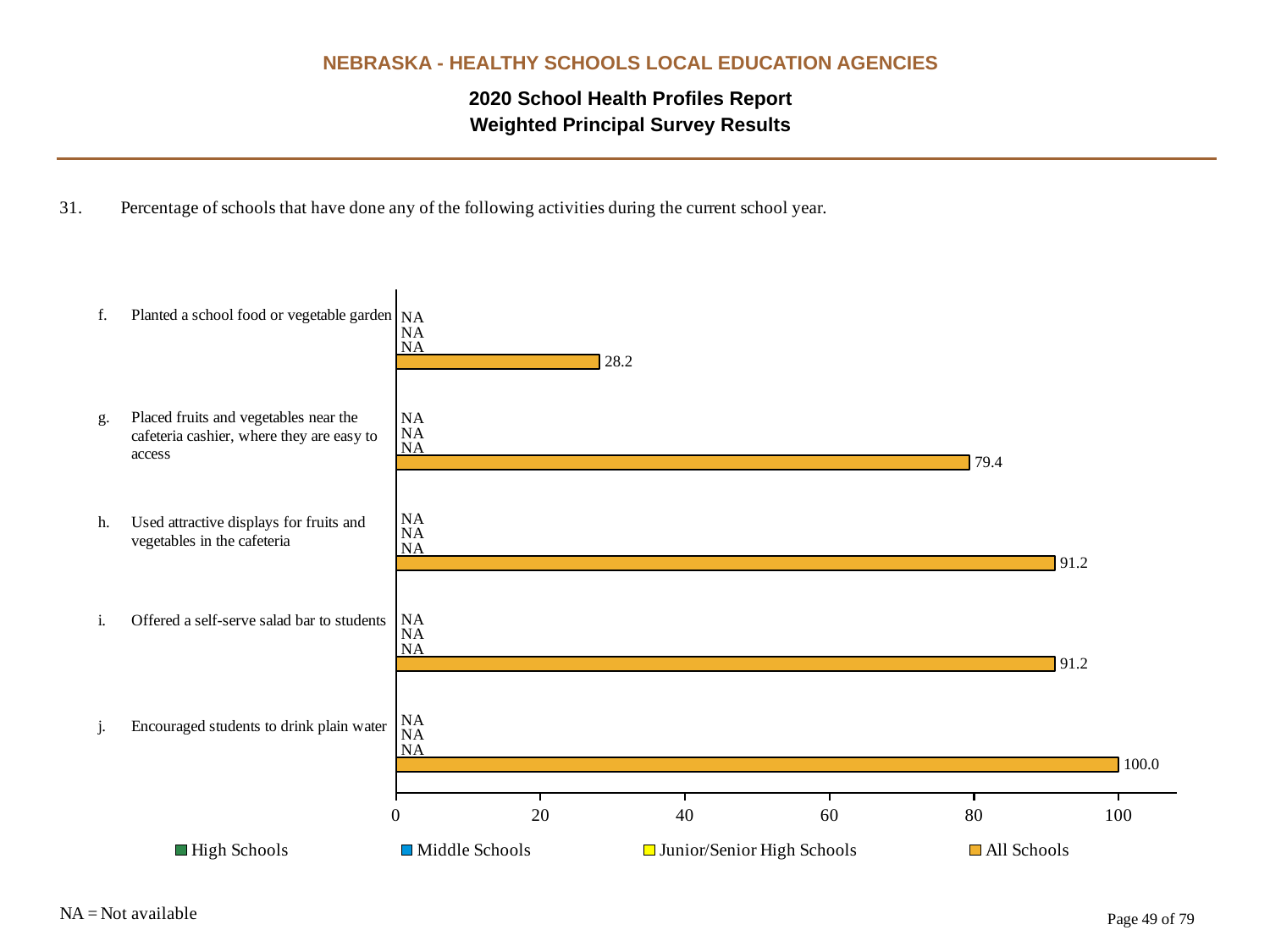
What is the difference between the All Schools values for 'Encouraged students to drink plain water' and 'Planted a school food or vegetable garden'? 71.8 What value is shown for High Schools for 'Offered a self-serve salad bar to students'? NA How many activities (categories) are shown in the chart? 5 Which has a larger All Schools value: 'Placed fruits and vegetables near the cafeteria cashier' or 'Used attractive displays for fruits and vegetables in the cafeteria'? Used attractive displays for fruits and vegetables in the cafeteria How many series does the legend list? 4 What is the All Schools value for 'Placed fruits and vegetables near the cafeteria cashier, where they are easy to access'? 79.4 What is the All Schools value for 'Encouraged students to drink plain water'? 100.0 What is the All Schools value for 'Planted a school food or vegetable garden'? 28.2 What kind of chart is shown on the slide? Bar chart Which activity has the lowest All Schools value? Planted a school food or vegetable garden Is the All Schools value for 'Placed fruits and vegetables near the cafeteria cashier' greater or less than 80? less Which activity has the highest All Schools value? Encouraged students to drink plain water